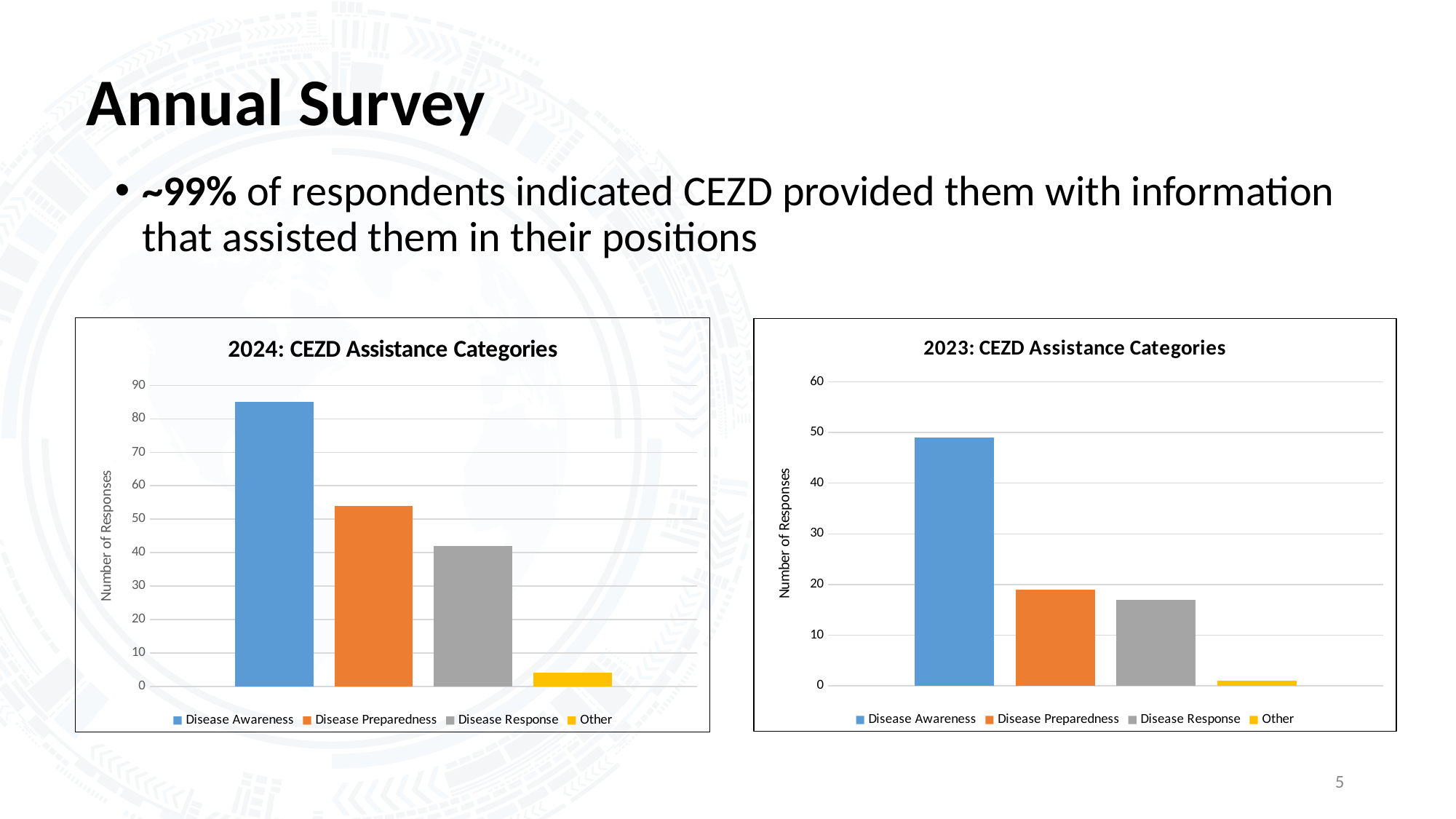
In the 2023: CEZD Assistance Categories chart, is the value for Disease Response greater or less than 20? less In the 2024: CEZD Assistance Categories chart, which is larger, Disease Preparedness or Disease Response? Disease Preparedness What is the y-axis label of the 2023: CEZD Assistance Categories chart? Number of Responses In the 2023: CEZD Assistance Categories chart, which category has the highest number of responses? Disease Awareness In the 2023: CEZD Assistance Categories chart, which category has the lowest number of responses? Other How many categories does the legend of the 2024: CEZD Assistance Categories chart list? 4 In the 2024: CEZD Assistance Categories chart, which category has the highest number of responses? Disease Awareness In the 2024: CEZD Assistance Categories chart, is the value for Disease Awareness greater or less than 80? greater In the 2023: CEZD Assistance Categories chart, is the value for Disease Awareness greater or less than 40? greater In the 2024: CEZD Assistance Categories chart, which category has the lowest number of responses? Other What type of chart is the 2024: CEZD Assistance Categories chart? bar chart